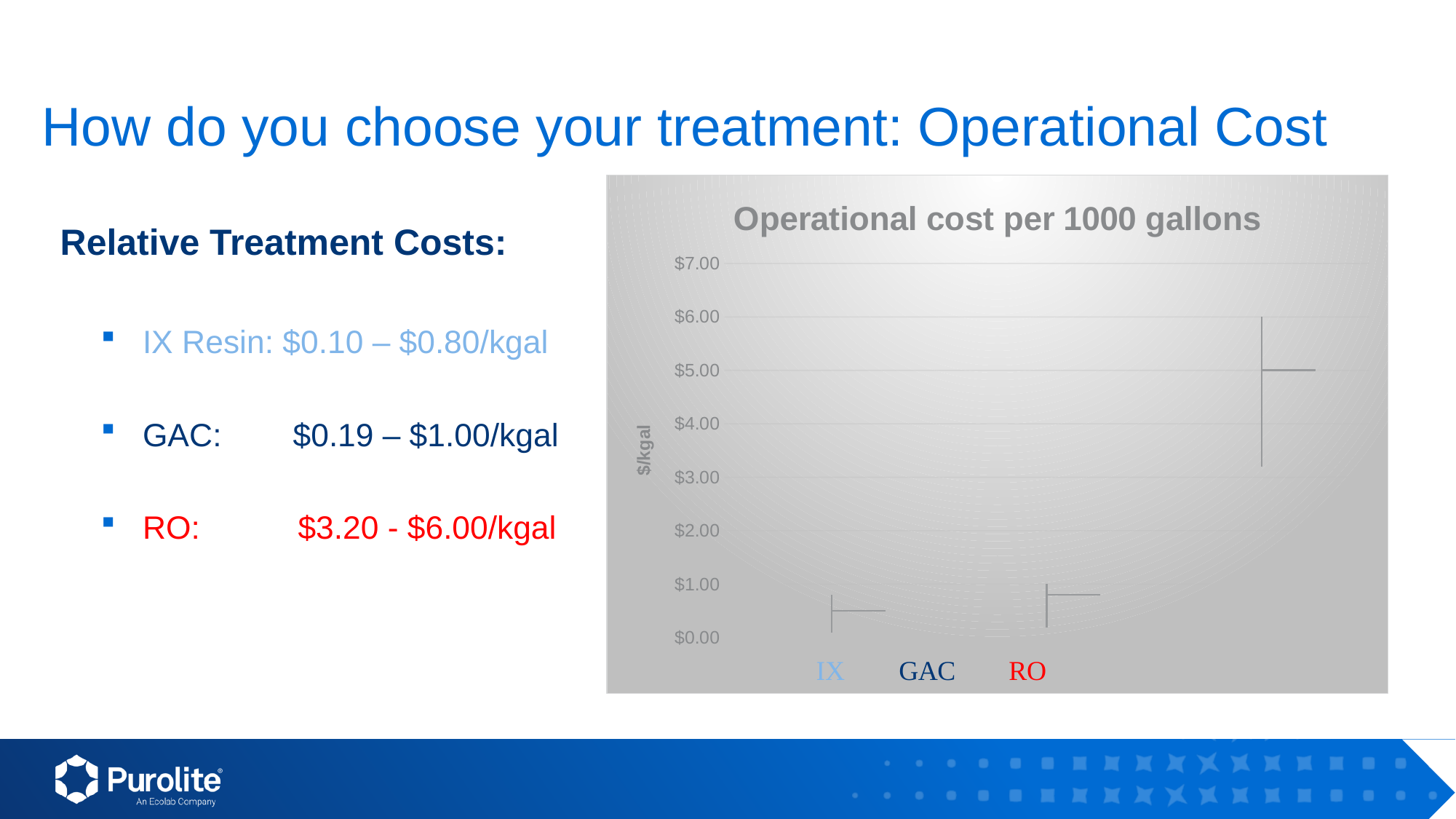
Which treatment has the lowest operational cost range in the chart? IX Is the upper end of the IX cost range greater or less than $1.00? less What value does the upper end of the RO range reach on the y axis? $6.00 Is the upper end of the GAC cost range greater or less than $2.00? less What is the label on the y axis of the chart? $/kgal Is the lower end of the RO cost range greater or less than $2.00? greater Which treatment has the highest operational cost range in the chart? RO Which has a higher operational cost in the chart, RO or GAC? RO What is the title of the chart? Operational cost per 1000 gallons How many treatment categories are shown on the x axis of the chart? 3